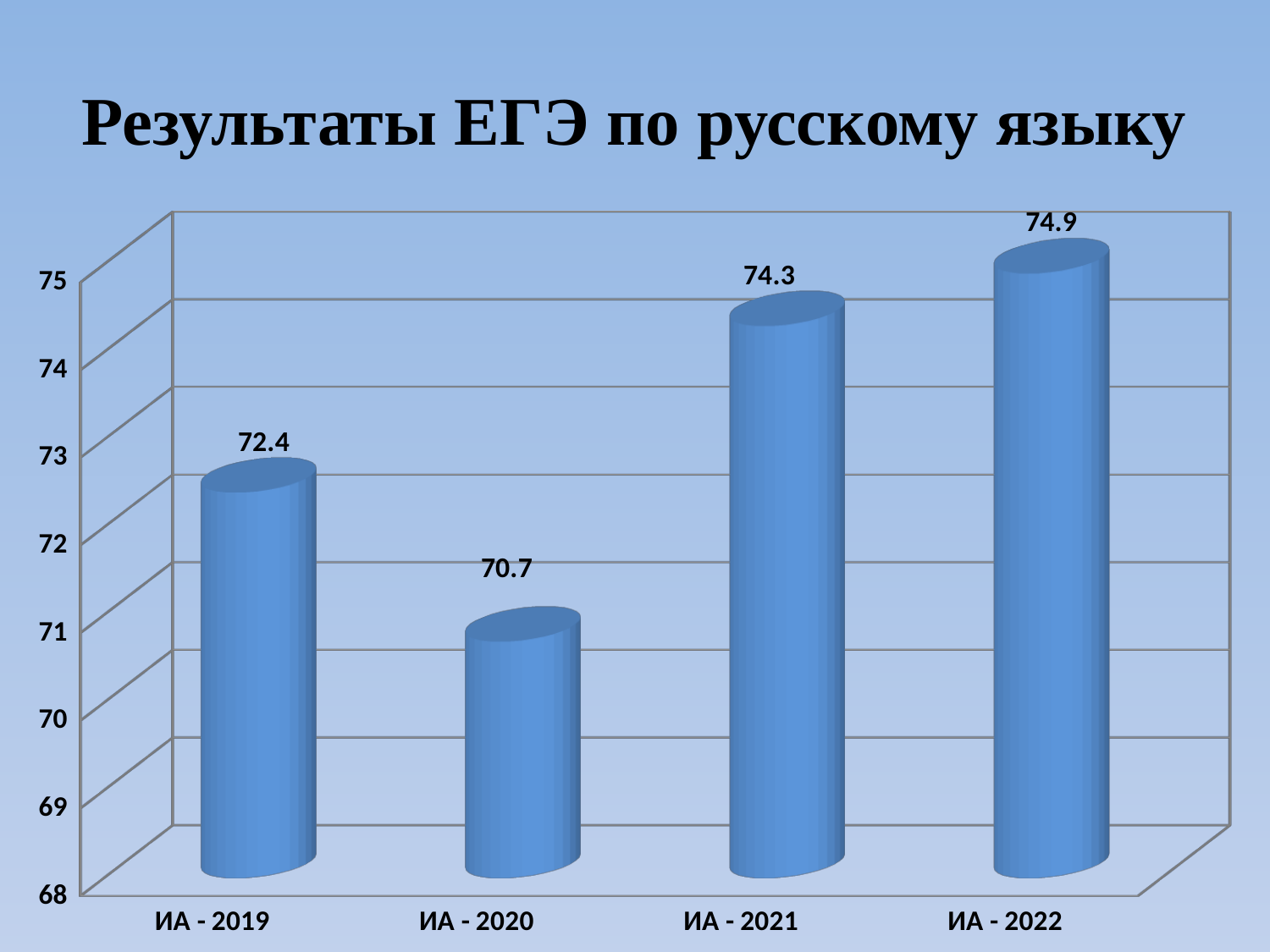
What is the value for ИА - 2019? 72.4 How many categories are shown on the chart? 4 What kind of chart is shown on the slide? Bar chart What is the title of the chart? Результаты ЕГЭ по русскому языку Which category has the highest value? ИА - 2022 What is the difference between the values for ИА - 2021 and ИА - 2019? 1.9 What is the value for ИА - 2021? 74.3 What is the difference between the values for ИА - 2022 and ИА - 2020? 4.2 What is the value for ИА - 2020? 70.7 Which is larger, the value for ИА - 2019 or the value for ИА - 2020? ИА - 2019 Which category has the lowest value? ИА - 2020 What is the value for ИА - 2022? 74.9